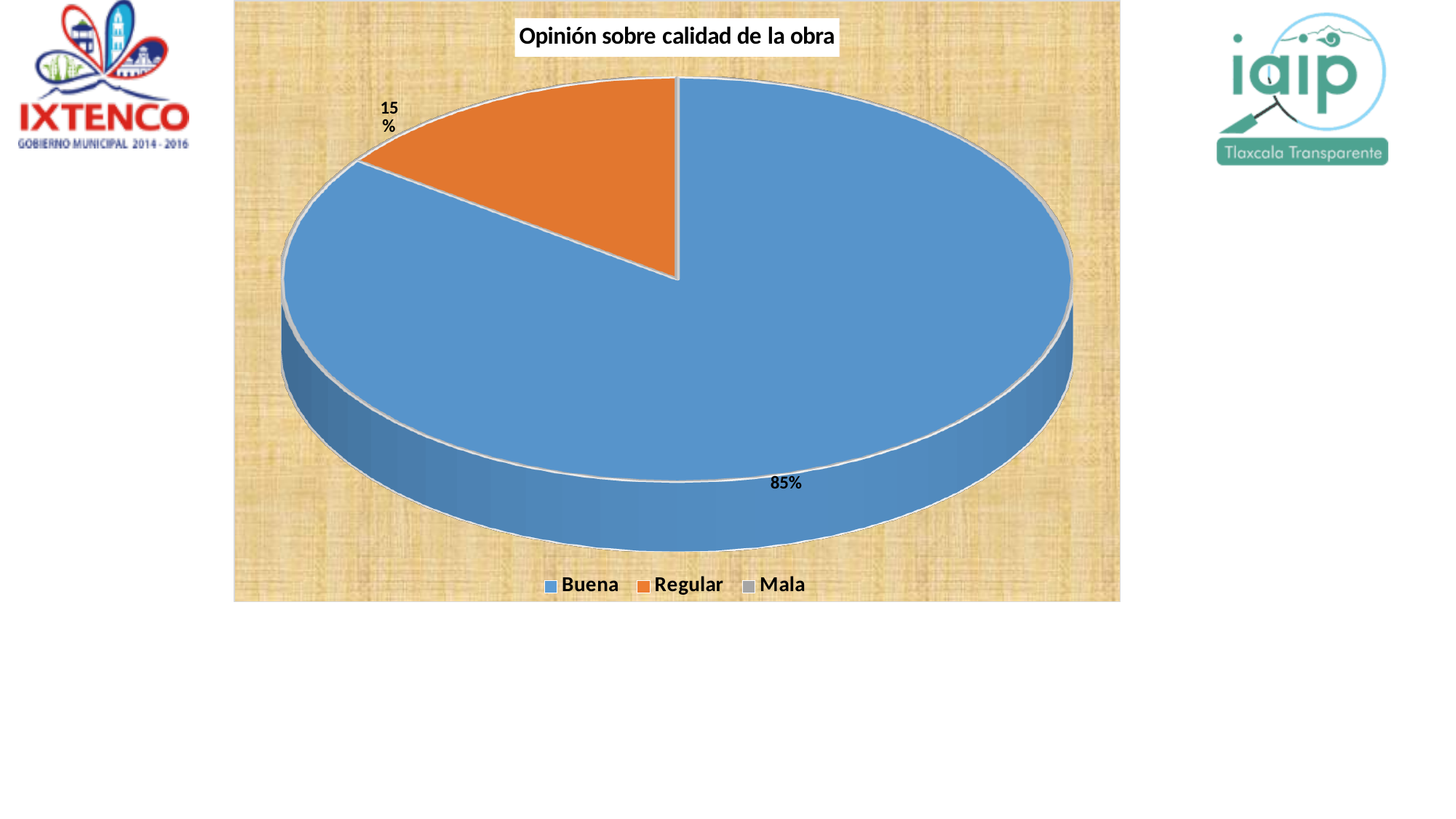
Which of Buena or Regular has the larger share? Buena What is the difference in percentage points between the Buena and Regular shares? 70 What colour is the Regular slice? orange How many entries does the legend list? 3 What is the title of the chart? Opinión sobre calidad de la obra What percentage of the pie is labelled for Buena? 85% Is the share for Regular greater or less than 25%? less What percentage of the pie is labelled for Regular? 15% Is the share for Buena greater or less than 50%? greater What kind of chart is shown on the slide? pie chart Which category has the largest share of the pie? Buena